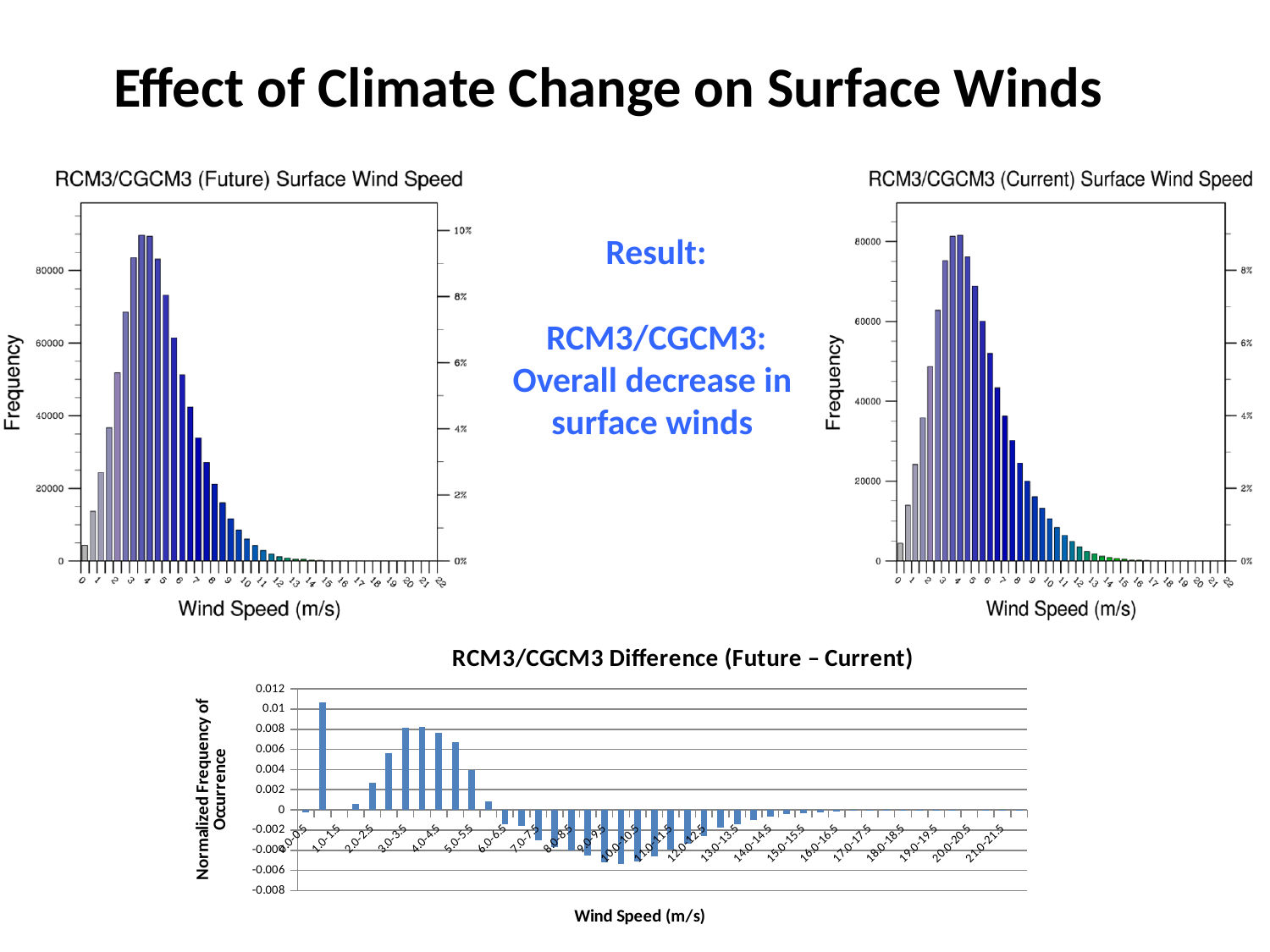
What is the title of the chart at the bottom of the slide? RCM3/CGCM3 Difference (Future – Current) In the 'RCM3/CGCM3 Difference (Future – Current)' chart, which bin has the larger value, 1.0-1.5 or 3.0-3.5? 3.0-3.5 In the 'RCM3/CGCM3 Difference (Future – Current)' chart, is the value for the 10.0-10.5 bin greater or less than -0.004? less In the 'RCM3/CGCM3 Difference (Future – Current)' chart, is the value for the 1.0-1.5 bin greater or less than 0.008? less What kind of chart is the 'RCM3/CGCM3 Difference (Future – Current)' chart at the bottom of the slide? bar chart In the 'RCM3/CGCM3 Difference (Future – Current)' chart, is the value for the 3.0-3.5 bin greater or less than 0.006? greater In the 'RCM3/CGCM3 (Future) Surface Wind Speed' chart, what is the highest percentage tick shown on the right-hand axis? 10% In the 'RCM3/CGCM3 Difference (Future – Current)' chart, do the values rise or fall from the 4.0-4.5 bin to the 7.0-7.5 bin? fall In the 'RCM3/CGCM3 Difference (Future – Current)' chart, which wind speed bin has the highest value? 0.5-1.0